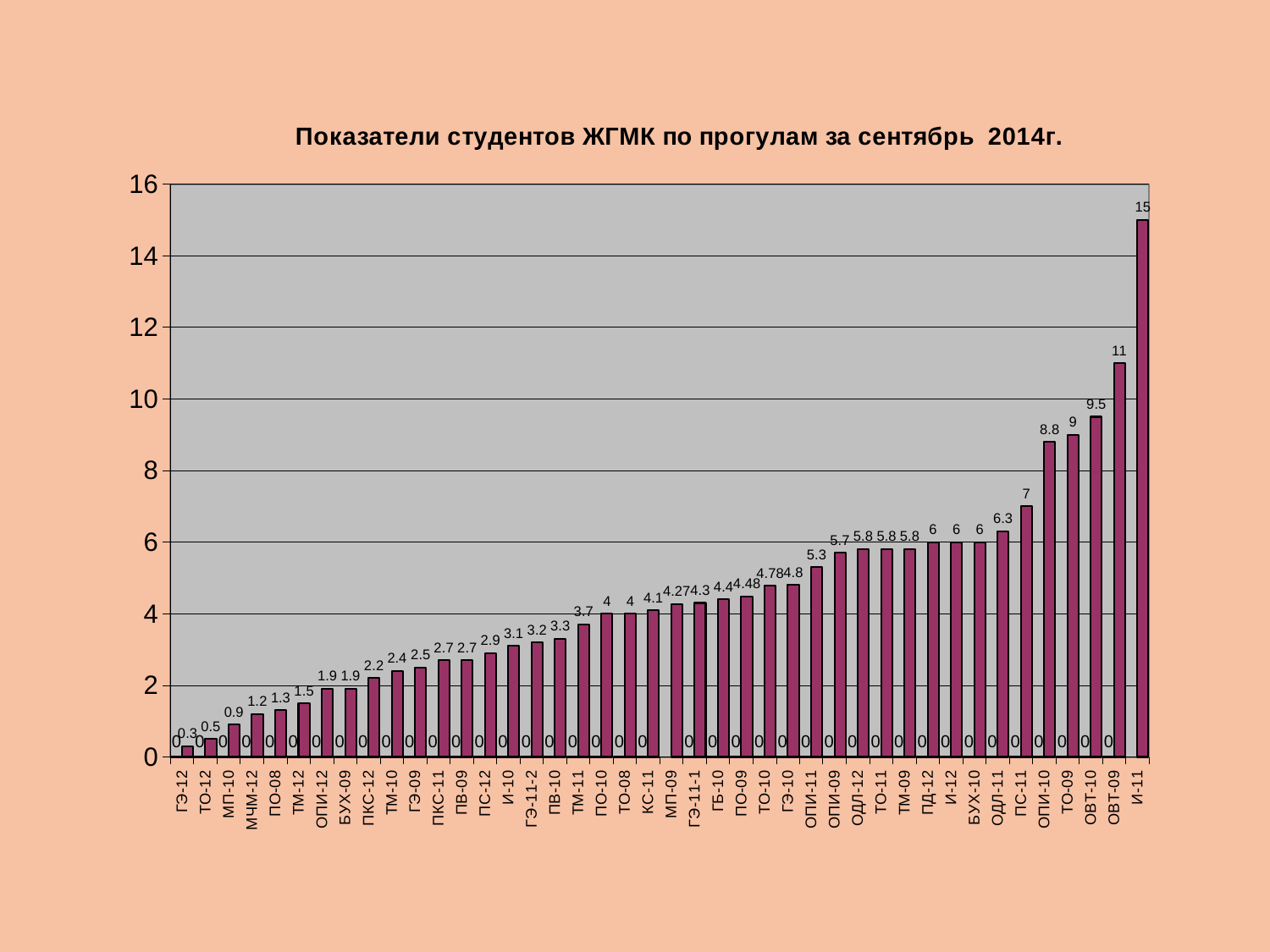
Do the values rise or fall from left to right along the x axis? rise Which category has the lowest value? ГЭ-12 What is the value for И-11? 15 What kind of chart is shown on the slide? bar chart Is the value for ОВТ-10 greater or less than 8? greater What is the value for ПС-11? 7 What is the difference between the values for ОВТ-10 and ОПИ-10? 0.7 Which category has the highest value? И-11 What is the value for ОВТ-09? 11 What is the difference between the values for И-11 and ОВТ-09? 4 Which is larger, the value for ОВТ-09 or the value for ТО-09? ОВТ-09 What is the value for ТМ-11? 3.7